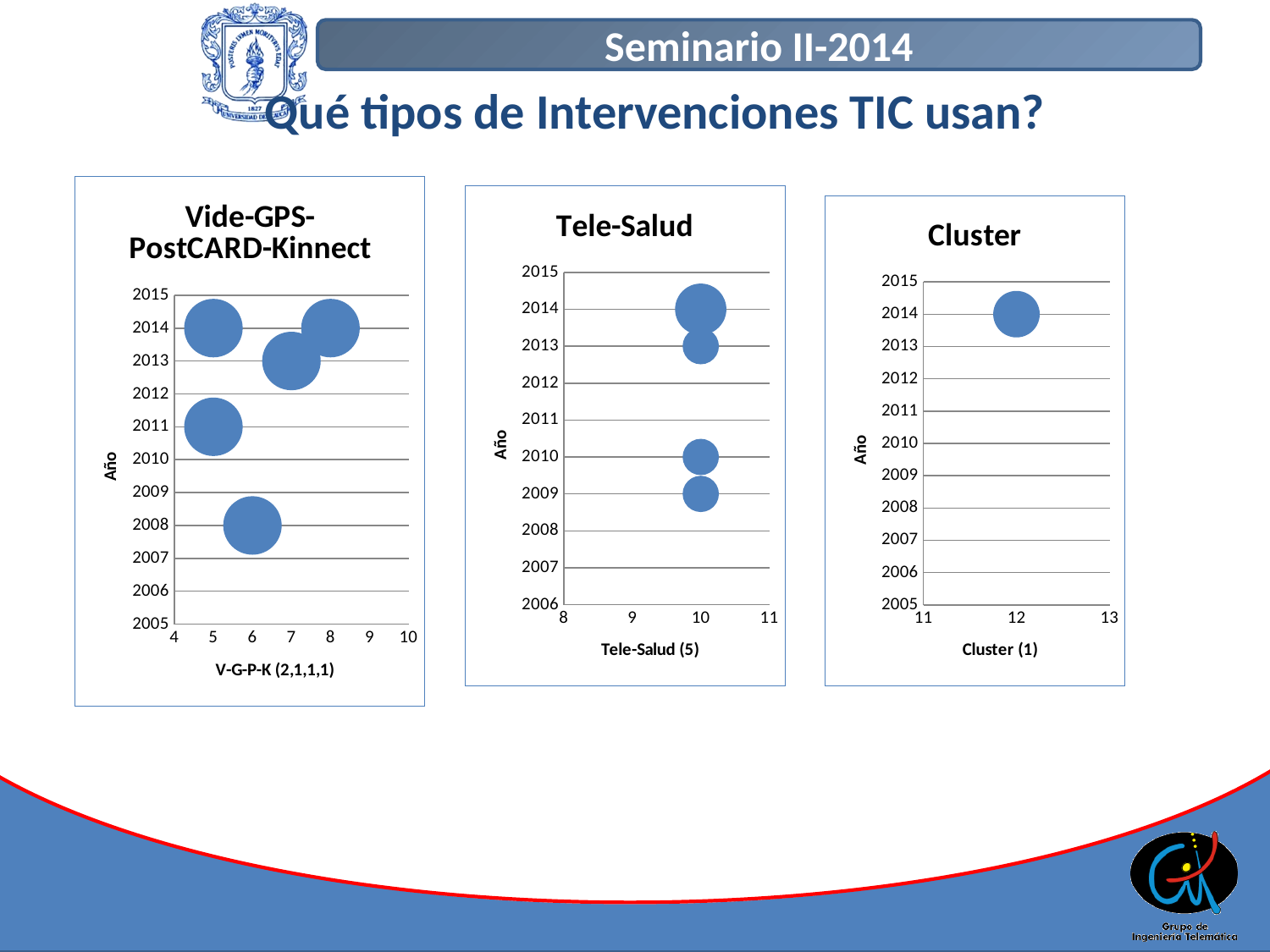
In the "Cluster" chart, which year does the bubble sit on? 2014 In the "Cluster" chart, how many bubbles are plotted? 1 In the "Cluster" chart, what is the x-axis title? Cluster (1) In the "Vide-GPS-PostCARD-Kinnect" chart, how many bubbles are plotted? 5 In the "Tele-Salud" chart, what is the earliest year with a bubble? 2009 In the "Tele-Salud" chart, how many bubbles are plotted? 4 In the "Vide-GPS-PostCARD-Kinnect" chart, which year does the bubble at x = 6 sit on? 2008 In the "Vide-GPS-PostCARD-Kinnect" chart, what is the earliest year with a bubble? 2008 In the "Tele-Salud" chart, what is the latest year with a bubble? 2014 In the "Tele-Salud" chart, what is the x-axis title? Tele-Salud (5) What kind of chart is the "Cluster" chart? bubble chart In the "Vide-GPS-PostCARD-Kinnect" chart, is the year of the bubble at x = 7 greater or less than 2010? greater